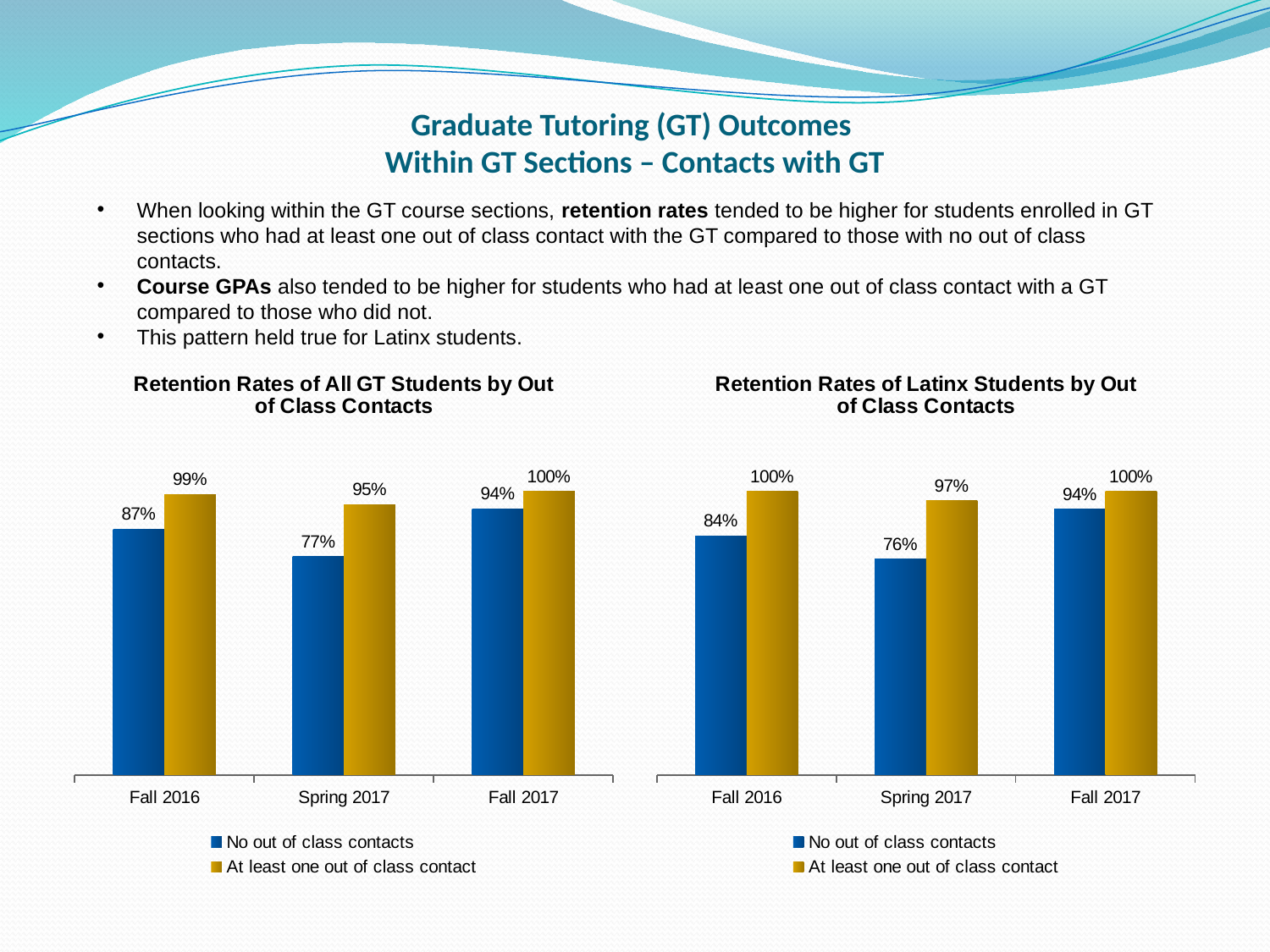
How many series does the legend of the 'Retention Rates of All GT Students by Out of Class Contacts' chart list? 2 In the 'Retention Rates of Latinx Students by Out of Class Contacts' chart, what is the difference between the retention rates of the two groups in Fall 2016? 16% In the 'Retention Rates of Latinx Students by Out of Class Contacts' chart, what is the retention rate for students with no out of class contacts in Spring 2017? 76% In the 'Retention Rates of All GT Students by Out of Class Contacts' chart, which term has the lowest retention rate for students with no out of class contacts? Spring 2017 How many terms are shown on the x axis of the 'Retention Rates of Latinx Students by Out of Class Contacts' chart? 3 In the 'Retention Rates of Latinx Students by Out of Class Contacts' chart, which term has the highest retention rate for students with no out of class contacts? Fall 2017 In the 'Retention Rates of All GT Students by Out of Class Contacts' chart, which group has the higher retention rate in Fall 2017? At least one out of class contact In the 'Retention Rates of Latinx Students by Out of Class Contacts' chart, what is the retention rate for students with at least one out of class contact in Fall 2017? 100% In the 'Retention Rates of All GT Students by Out of Class Contacts' chart, what is the retention rate for students with no out of class contacts in Fall 2016? 87% In the 'Retention Rates of All GT Students by Out of Class Contacts' chart, what is the difference between the retention rates of the two groups in Spring 2017? 18% In the 'Retention Rates of All GT Students by Out of Class Contacts' chart, what is the retention rate for students with at least one out of class contact in Spring 2017? 95% What type of chart is the 'Retention Rates of Latinx Students by Out of Class Contacts' chart? Bar chart